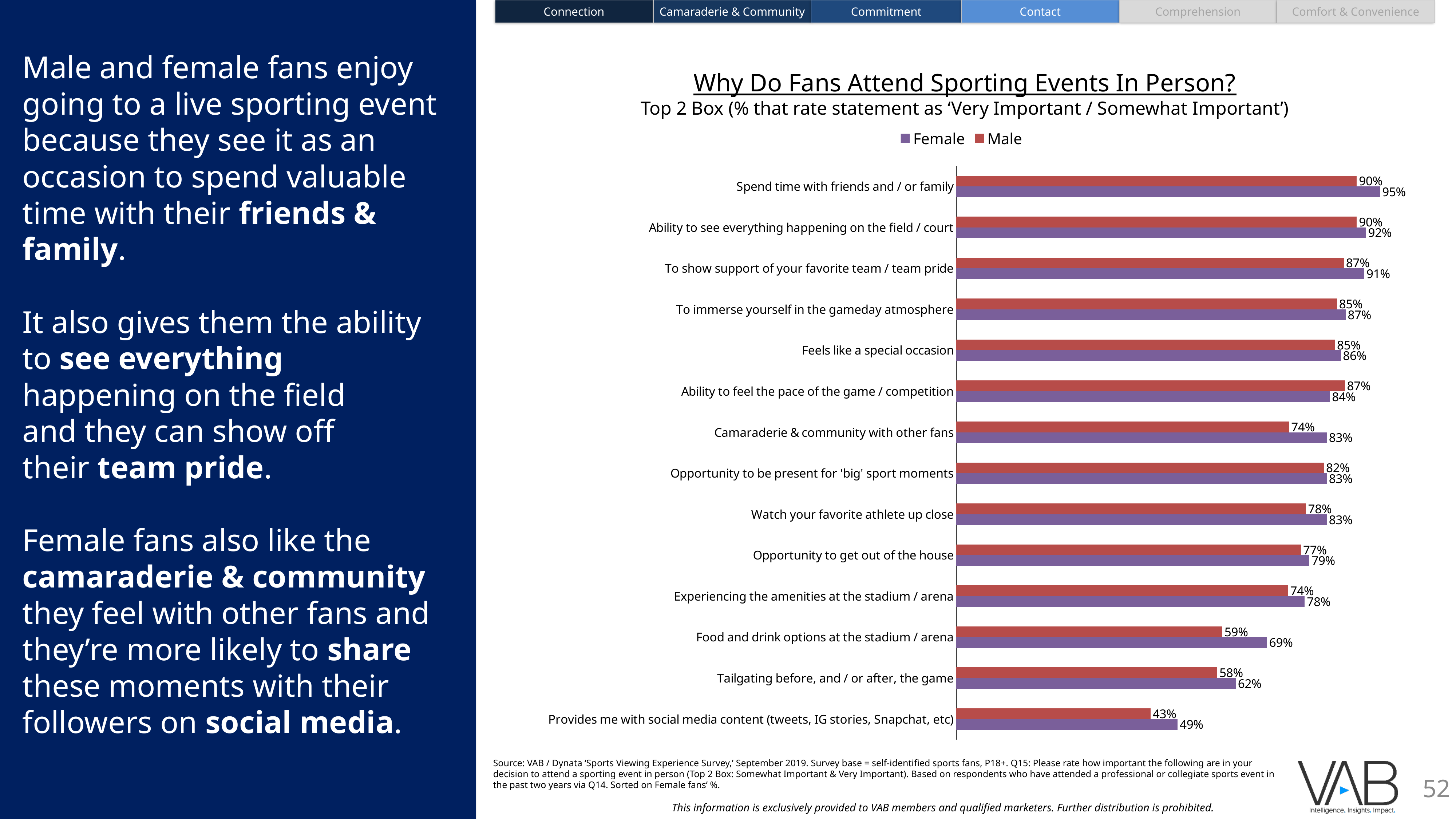
Which category has the highest Female value? Spend time with friends and / or family What is the difference between the Female and Male values for 'Camaraderie & community with other fans'? 9 percentage points What type of chart is shown on the slide? Bar chart How many series does the legend list? 2 Which colour represents the Female series in the chart? Purple How many categories (reasons) are shown in the chart? 14 Which category has the lowest Female value? Provides me with social media content (tweets, IG stories, Snapchat, etc) What percentage of male fans rate 'Camaraderie & community with other fans' as important? 74% What is the difference between the Female and Male values for 'Food and drink options at the stadium / arena'? 10 percentage points What is the Male value for 'Food and drink options at the stadium / arena'? 59% For 'Ability to feel the pace of the game / competition', which is larger, the Male or Female value? Male What percentage of female fans rate 'Spend time with friends and / or family' as important? 95%